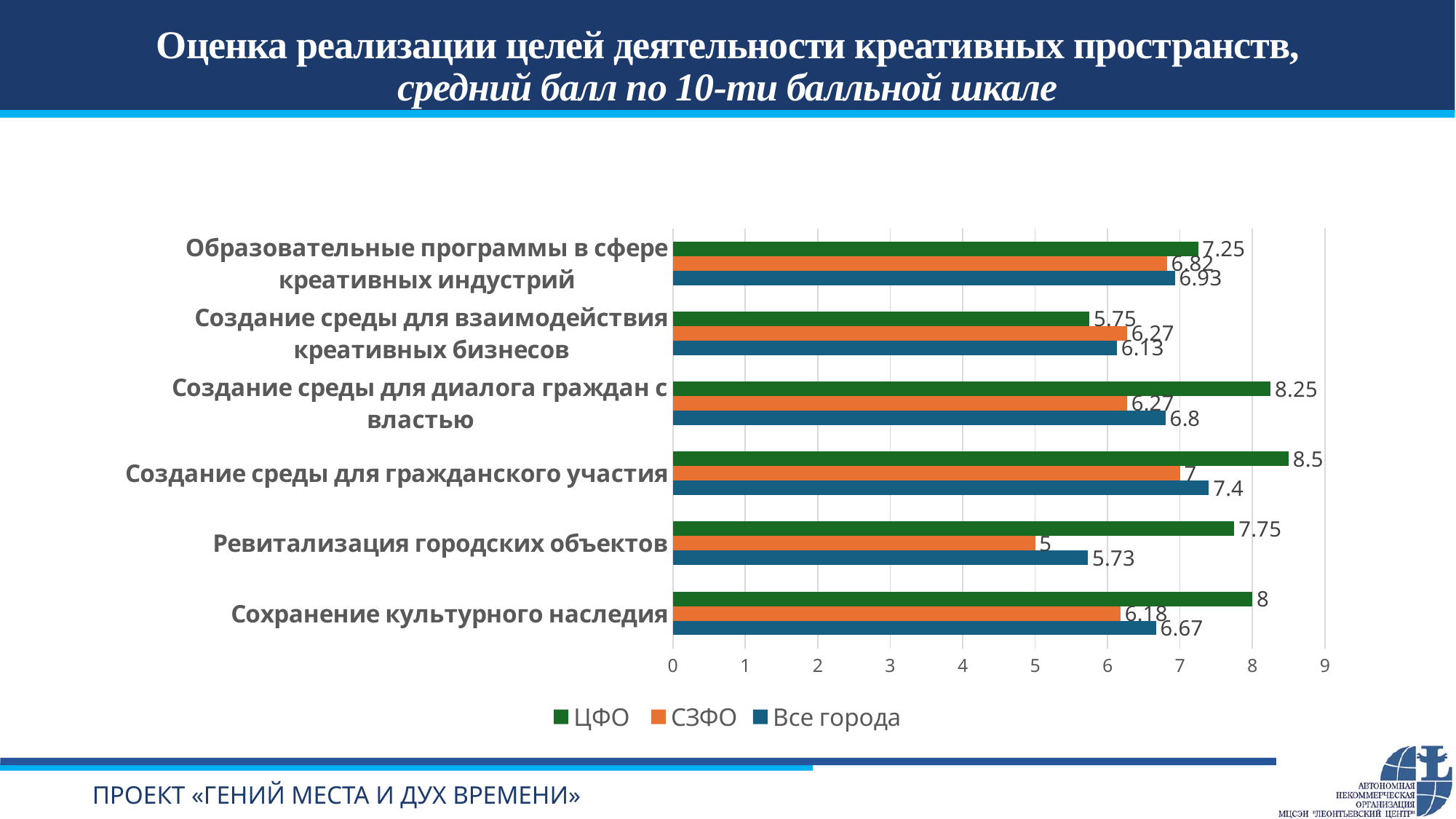
What is the СЗФО value for «Ревитализация городских объектов»? 5 Which category has the lowest СЗФО value? Ревитализация городских объектов Which colour represents the «Все города» series in the legend? blue Which category has the highest ЦФО value? Создание среды для гражданского участия What is the «Все города» value for «Образовательные программы в сфере креативных индустрий»? 6.93 How many series does the legend list? 3 Which category has the lowest «Все города» value? Ревитализация городских объектов What is the difference between the ЦФО and СЗФО values for «Ревитализация городских объектов»? 2.75 For «Создание среды для взаимодействия креативных бизнесов», which is larger: the ЦФО value or the СЗФО value? СЗФО What is the ЦФО value for «Создание среды для гражданского участия»? 8.5 How many categories are shown on the chart? 6 What type of chart is shown on the slide? bar chart